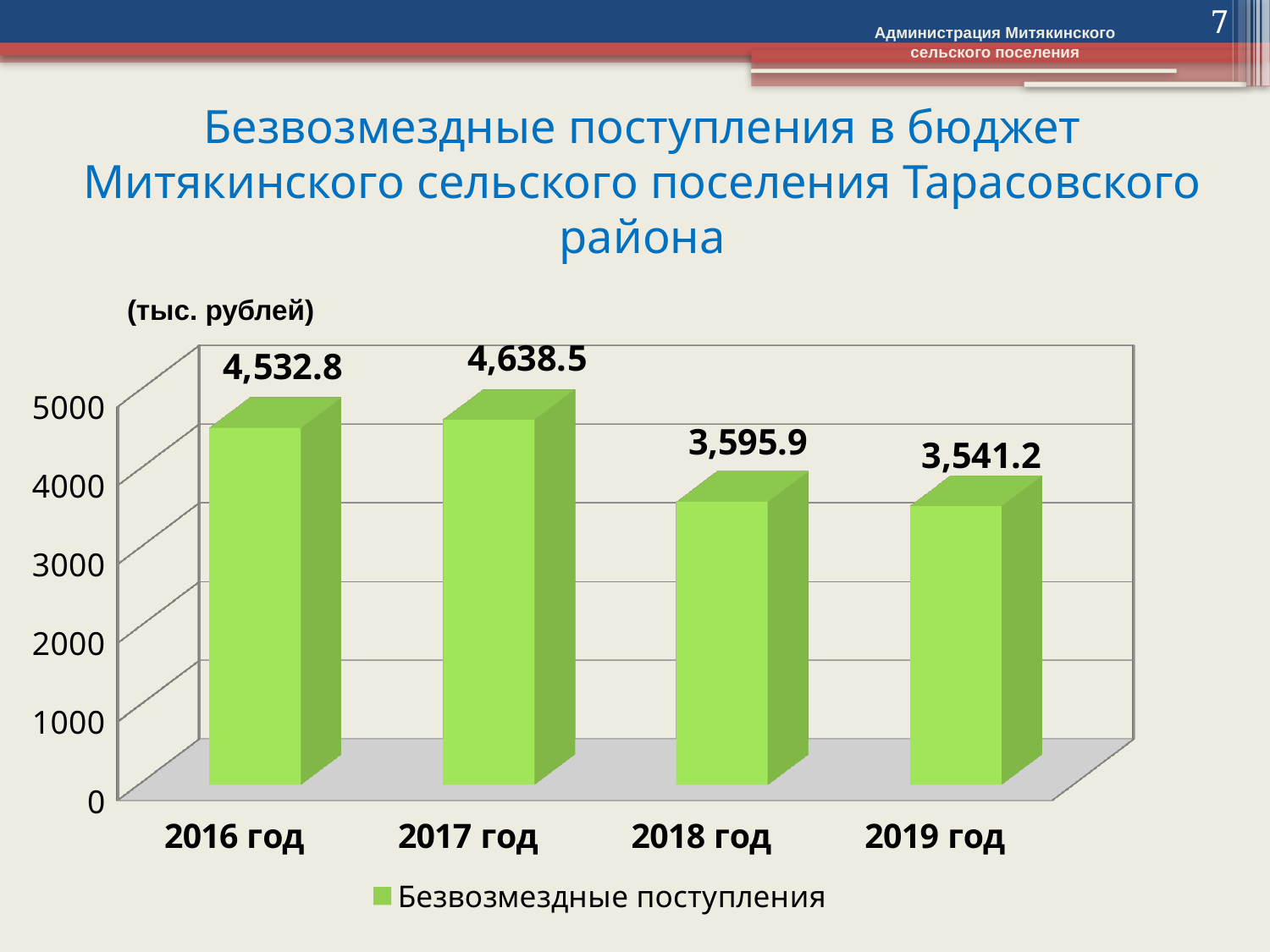
Is the value for 2018 год greater or less than 4000? less What kind of chart is shown? bar chart Which year has the lowest value? 2019 год Which is larger, the value for 2016 год or the value for 2019 год? 2016 год What is the value for 2016 год? 4,532.8 How many years are shown on the x axis? 4 Which year has the highest value? 2017 год How many series does the legend list? 1 What is the value for 2017 год? 4,638.5 What unit is stated above the chart? тыс. рублей What is the value for 2019 год? 3,541.2 What is the difference between the values for 2017 год and 2018 год? 1,042.6